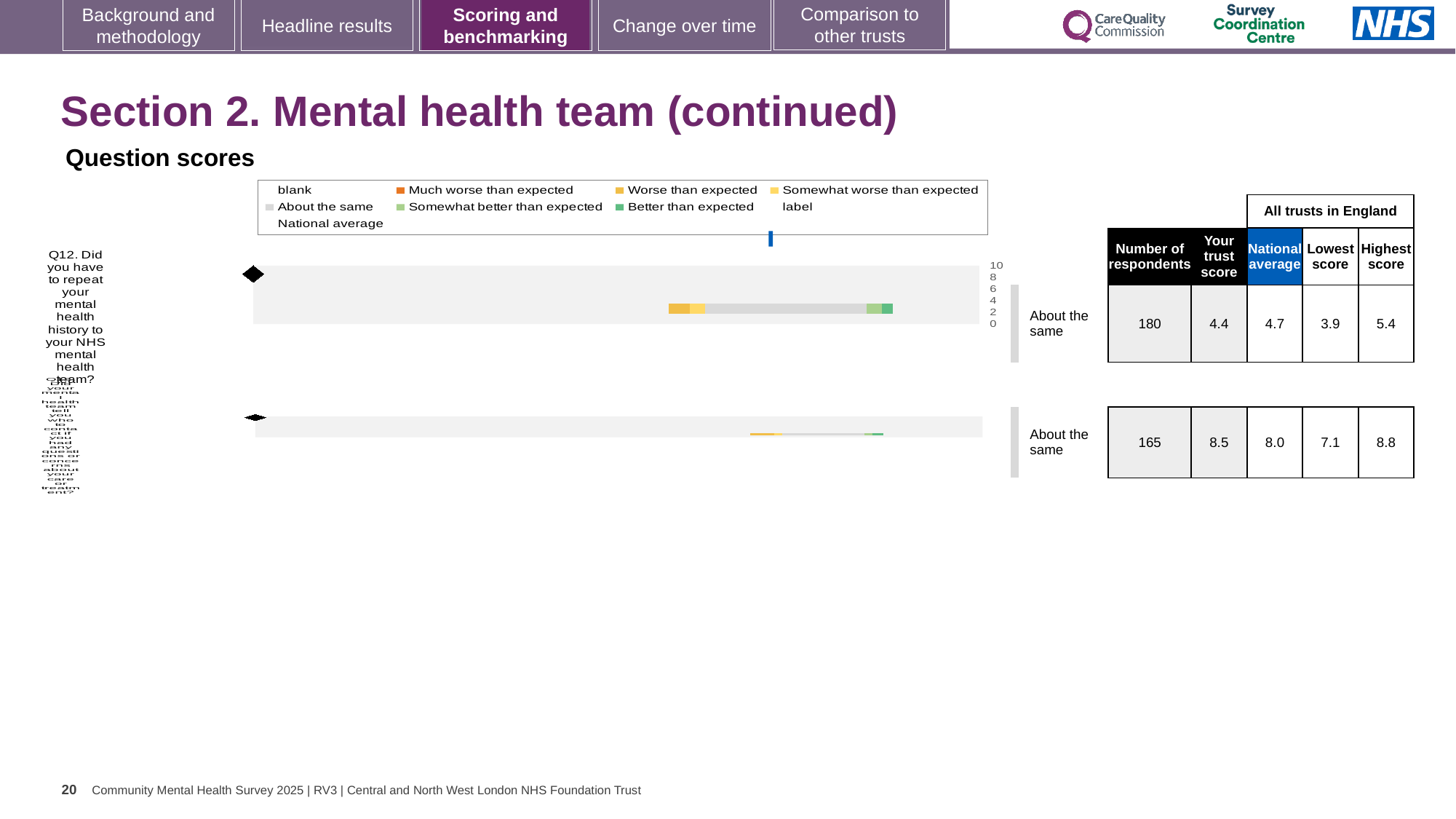
For the Q12 chart, how many respondents are shown in the table? 180 For the Q12 chart, what is the difference between the highest and lowest scores among all trusts in England? 1.5 For the lower chart on the slide, which is larger: the trust's score or the national average? Your trust score For the lower chart on the slide, what is the difference between the trust's score and the national average? 0.5 For the chart for Q12 (Did you have to repeat your mental health history to your NHS mental health team?), what is the trust's score shown in the table? 4.4 For the Q12 chart, what is the lowest score among all trusts in England? 3.9 What benchmark category label is shown next to the Q12 chart? About the same For the lower chart on the slide, what is the trust's score shown in the table? 8.5 For the lower chart on the slide, how many respondents are shown in the table? 165 For the Q12 chart, what is the highest score among all trusts in England? 5.4 For the Q12 chart, what is the national average score shown in the table? 4.7 For the Q12 chart, which is larger: the trust's score or the national average? National average